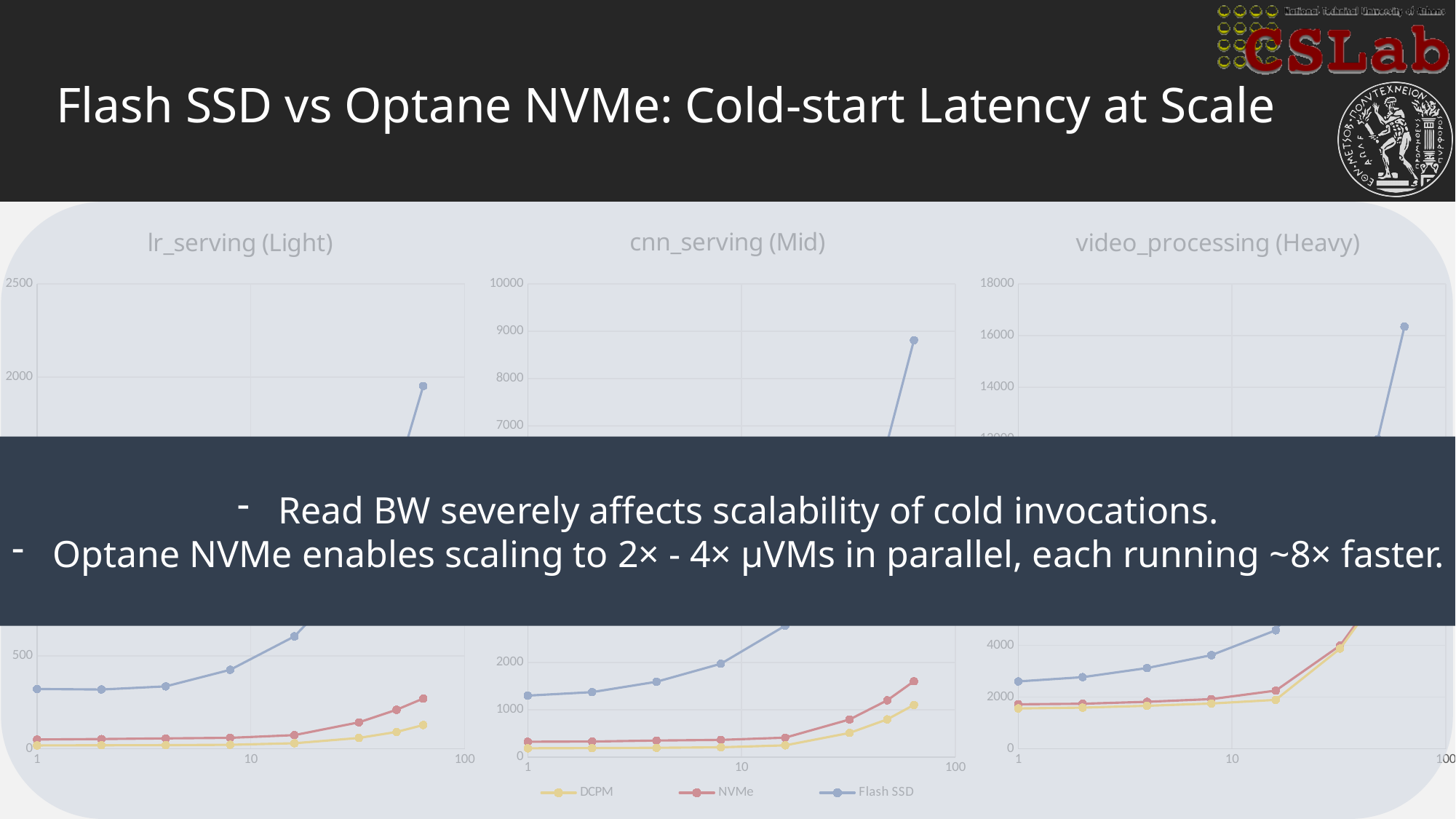
In the lr_serving (Light) chart, which is larger at x = 1: the Flash SSD value or the DCPM value? Flash SSD In the cnn_serving (Mid) chart, is the NVMe value at x = 1 greater or less than 1000? less What kind of chart is the lr_serving (Light) chart? line chart In the lr_serving (Light) chart, is the Flash SSD value at x = 1 greater or less than 500? less In the cnn_serving (Mid) chart, is the highest Flash SSD value greater or less than 8000? greater In the cnn_serving (Mid) chart, do the Flash SSD values rise or fall as the x axis increases? rise What is the title of the middle chart? cnn_serving (Mid) How many series does the legend list for the charts? 3 In the video_processing (Heavy) chart, which series has the lowest values? DCPM What are the three series named in the legend? DCPM, NVMe, Flash SSD In the lr_serving (Light) chart, which series has the highest values? Flash SSD